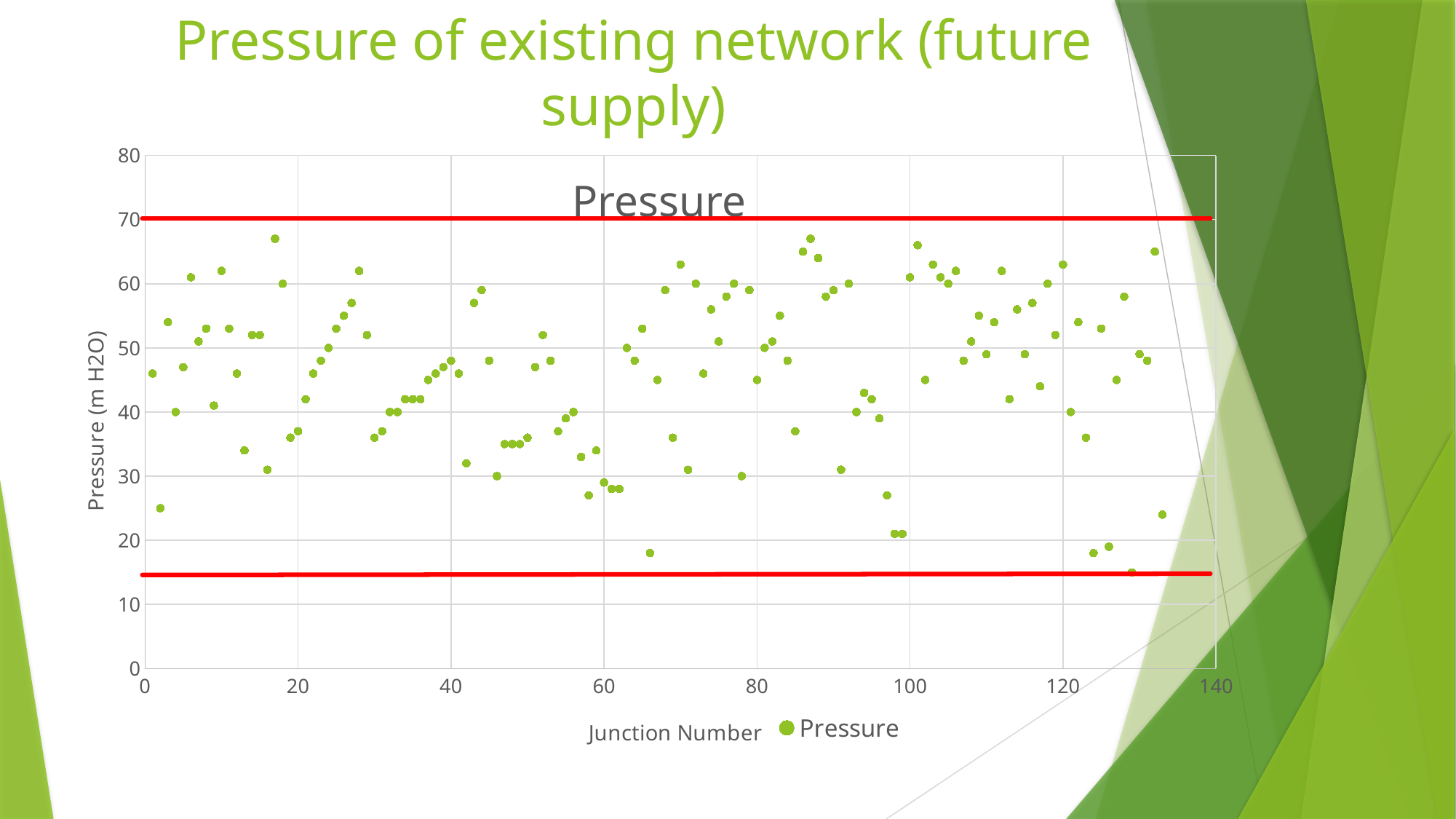
Is the lower red horizontal line above or below 20 on the pressure axis? below At what pressure value is the upper red horizontal line drawn? 70 What kind of chart is shown on the slide? Scatter chart What is the maximum value shown on the horizontal axis? 140 What is the maximum value shown on the vertical axis? 80 What is the title shown inside the chart area? Pressure Is the highest plotted pressure value greater or less than 70? less Is the lowest plotted pressure value greater or less than 20? less What is the label of the vertical axis? Pressure (m H2O) Do any plotted points lie above the upper red line? No How many series does the chart legend list? 1